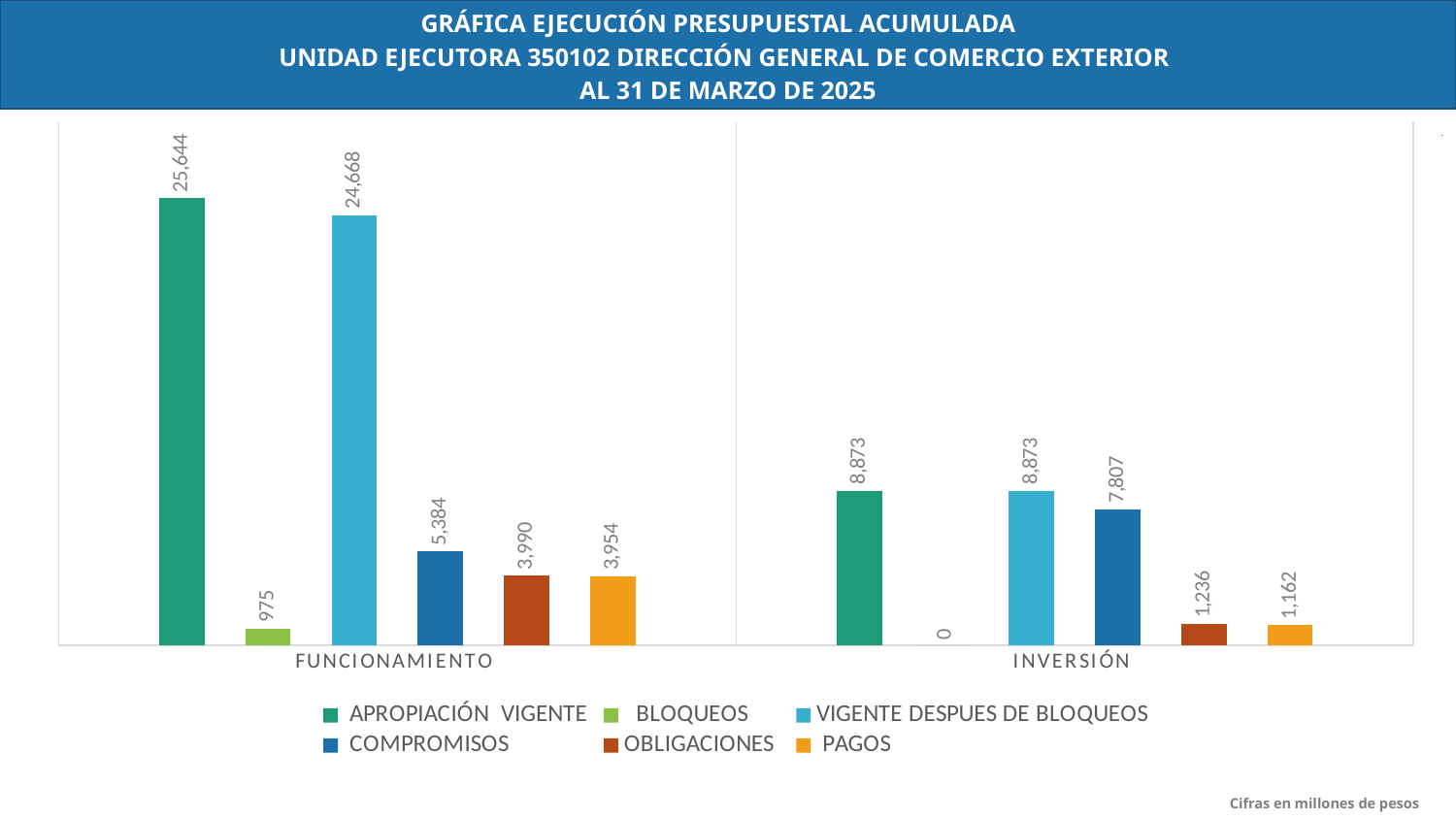
Which series has the highest value for FUNCIONAMIENTO? APROPIACIÓN VIGENTE What is the value of BLOQUEOS for INVERSIÓN? 0 Which series has the lowest value for INVERSIÓN? BLOQUEOS Which is larger, COMPROMISOS for FUNCIONAMIENTO or COMPROMISOS for INVERSIÓN? COMPROMISOS for INVERSIÓN How many series does the legend list? 6 What is the difference between OBLIGACIONES and PAGOS for INVERSIÓN? 74 What is the value of APROPIACIÓN VIGENTE for FUNCIONAMIENTO? 25,644 What is the difference between APROPIACIÓN VIGENTE and VIGENTE DESPUES DE BLOQUEOS for FUNCIONAMIENTO? 976 What is the value of PAGOS for FUNCIONAMIENTO? 3,954 How many categories are shown on the x axis? 2 What is the value of COMPROMISOS for INVERSIÓN? 7,807 What kind of chart is shown on the slide? Bar chart